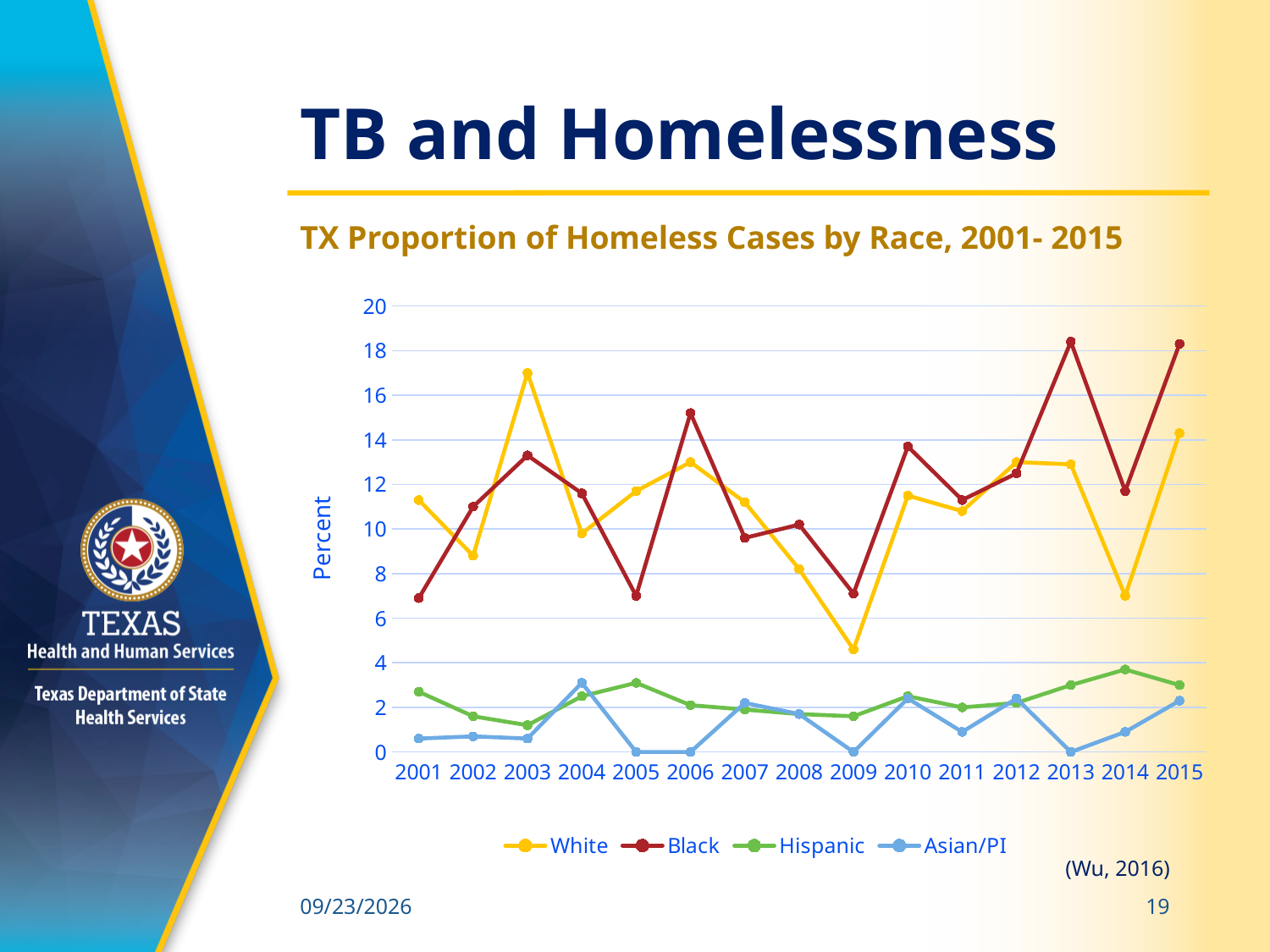
In 2009, which is larger, the value for Black or the value for White? Black Is the value for White in 2009 greater or less than 6? less Is the value for Black in 2006 greater or less than 14? greater What is the title of the chart? TX Proportion of Homeless Cases by Race, 2001- 2015 What kind of chart is shown on the slide? line chart How many years are plotted along the x axis? 15 How many series does the legend list? 4 Is the value for White in 2003 greater or less than 16? greater In which year does the White series reach its lowest value? 2009 Which series is drawn in red? Black In which year does the White series reach its highest value? 2003